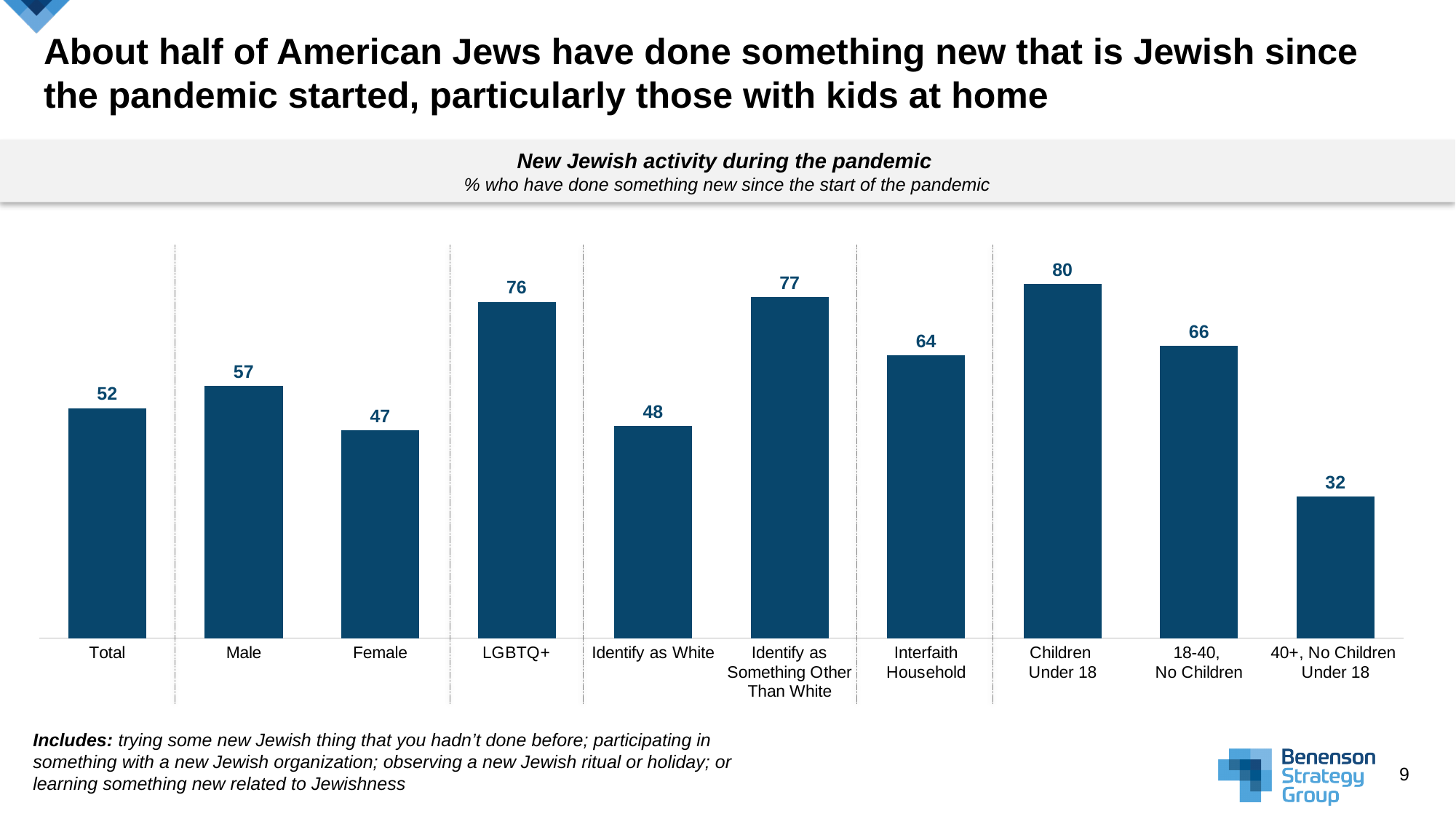
Which category has the lowest value? 40+, No Children Under 18 Which is larger, the value for LGBTQ+ or the value for 18-40, No Children? LGBTQ+ How many categories are shown in the chart? 10 What is the value for Total? 52 Which category has the highest value? Children Under 18 What is the title of the chart? New Jewish activity during the pandemic What is the difference between the values for Male and Female? 10 What is the value for 40+, No Children Under 18? 32 What is the value for Children Under 18? 80 What is the value for Interfaith Household? 64 What kind of chart is shown on the slide? Bar chart What is the difference between the values for Children Under 18 and 40+, No Children Under 18? 48